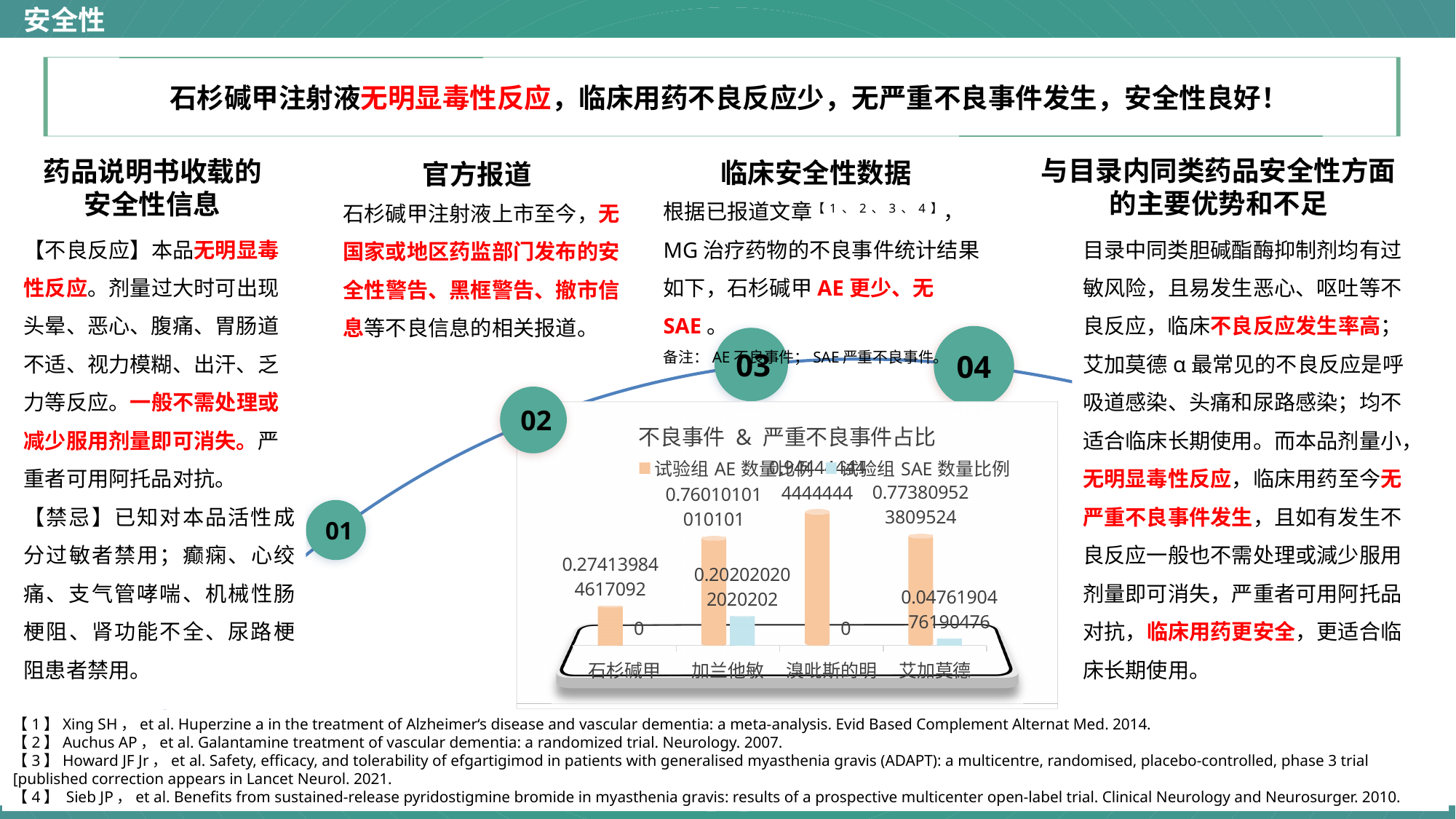
Which has the larger 试验组 SAE 数量比例, 加兰他敏 or 艾加莫德? 加兰他敏 How many series does the chart legend list? 2 What is the 试验组 SAE 数量比例 value for 加兰他敏? 0.202020202020202 What is the 试验组 AE 数量比例 value for 艾加莫德? 0.773809523809524 What kind of chart is shown on the slide? bar chart What is the 试验组 AE 数量比例 value for 石杉碱甲? 0.274139844617092 What is the title of the chart? 不良事件 & 严重不良事件占比 What is the 试验组 SAE 数量比例 value for 石杉碱甲? 0 How many drug categories are shown on the x axis of the chart? 4 Which drug has the lowest 试验组 AE 数量比例? 石杉碱甲 What is the 试验组 SAE 数量比例 value for 艾加莫德? 0.0476190476190476 Which drug has the highest 试验组 AE 数量比例? 溴吡斯的明